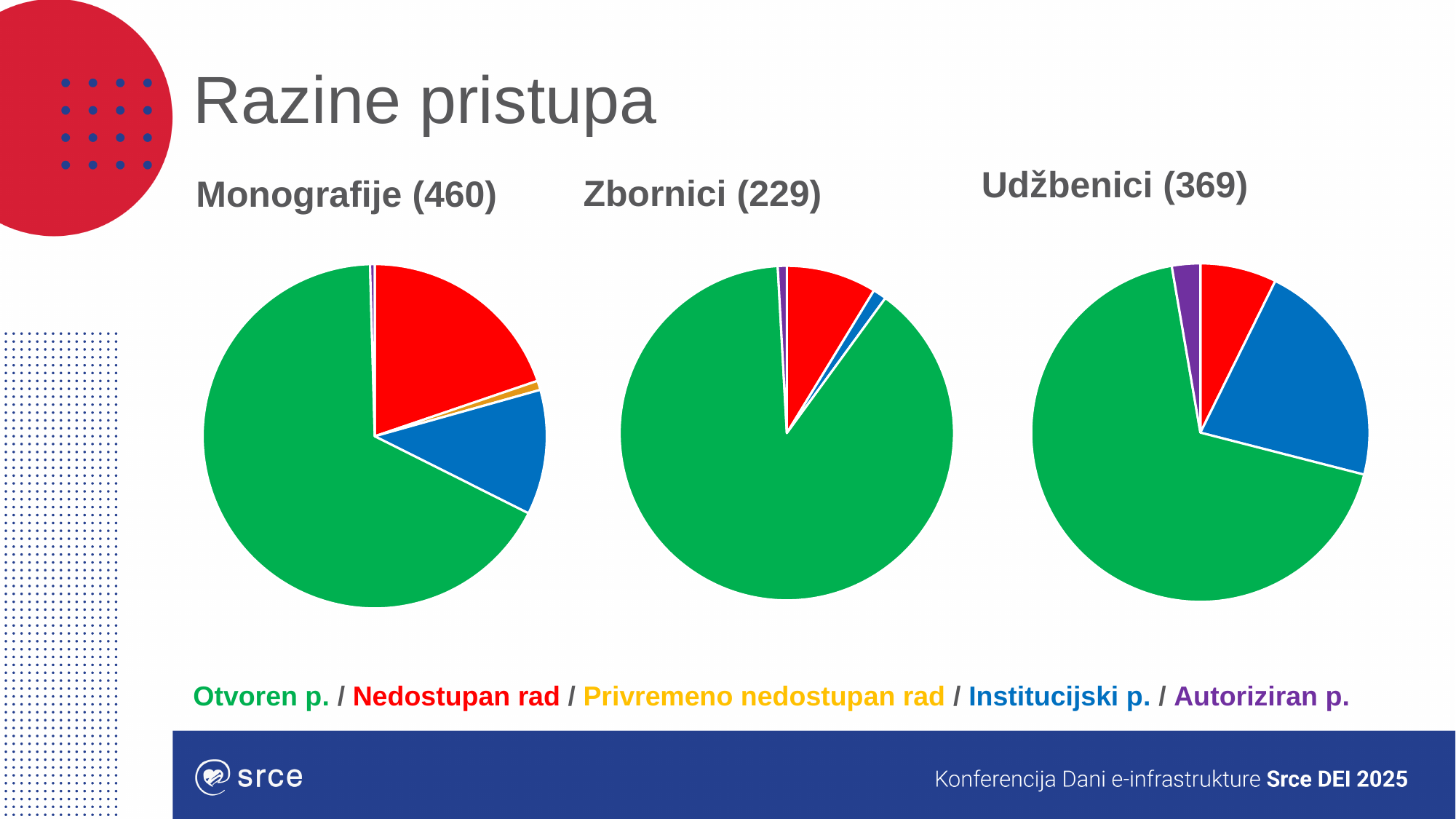
In the Monografije (460) chart, which category has the largest slice? Otvoren p. How many categories does the shared legend below the charts list? 5 How many slices does the Zbornici (229) pie chart have? 4 What colour represents Privremeno nedostupan rad in the legend? yellow In the Zbornici (229) chart, which slice is larger: Nedostupan rad or Institucijski p.? Nedostupan rad What is the title of the slide? Razine pristupa What kind of chart is used for Monografije (460)? pie chart In the Udžbenici (369) chart, which slice is larger: Institucijski p. or Nedostupan rad? Institucijski p. In the Zbornici (229) chart, which category has the largest slice? Otvoren p. In the Udžbenici (369) chart, which category has the largest slice? Otvoren p. In the Udžbenici (369) chart, which category has the smallest slice? Autoriziran p. In the Monografije (460) chart, which slice is larger: Nedostupan rad or Institucijski p.? Nedostupan rad